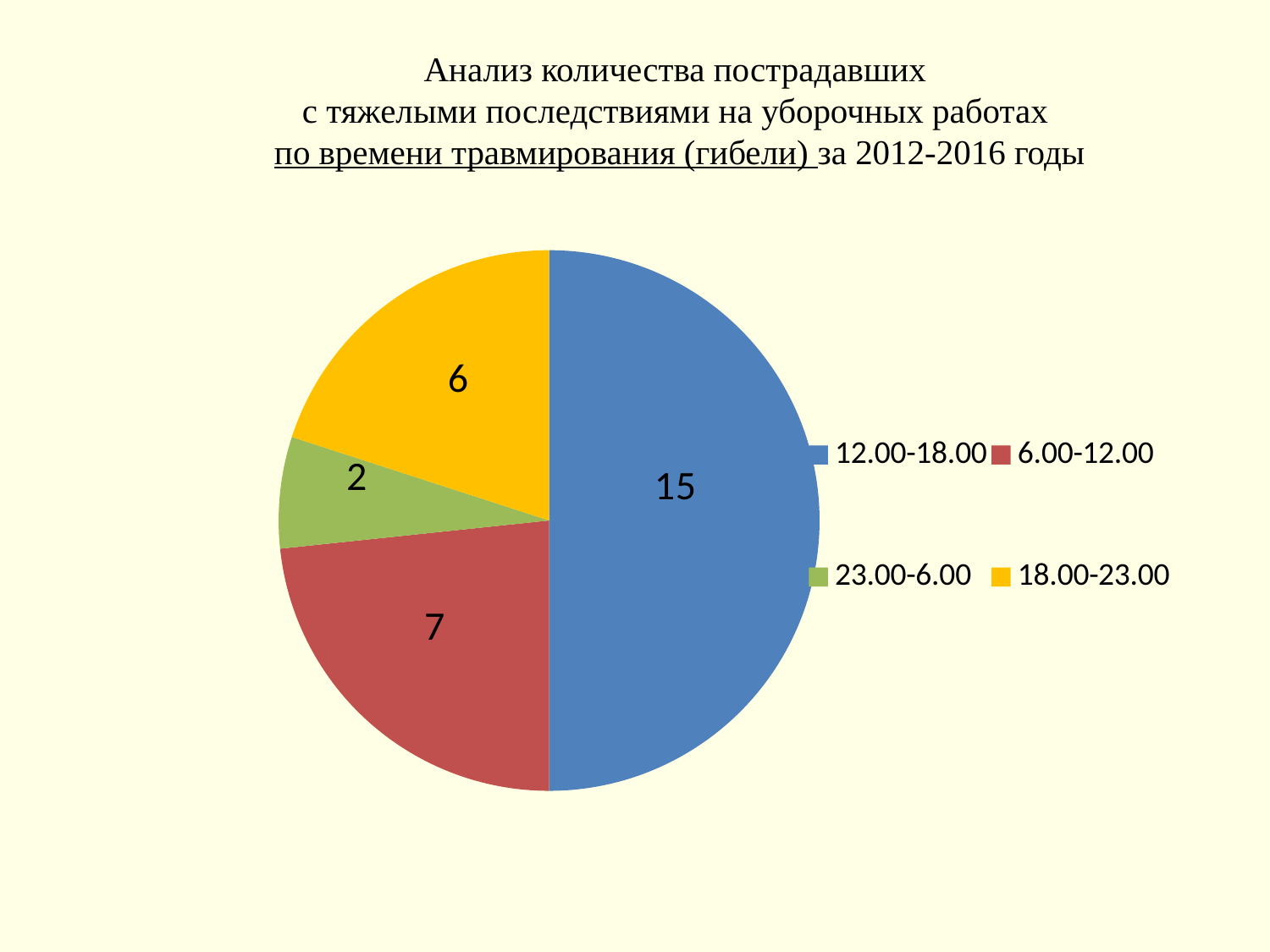
What is the value for the 23.00-6.00 slice? 2 What is the value for the 6.00-12.00 slice? 7 Which is larger, the value for 18.00-23.00 or the value for 6.00-12.00? 6.00-12.00 What colour is the 18.00-23.00 slice? yellow How many slices does the pie chart have? 4 What kind of chart is shown on the slide? pie chart Which time period has the smallest slice? 23.00-6.00 What share of the pie does the 12.00-18.00 slice represent? 50% What is the value for the 12.00-18.00 slice? 15 What is the value for the 18.00-23.00 slice? 6 Which time period has the largest slice? 12.00-18.00 What is the difference between the values for 12.00-18.00 and 6.00-12.00? 8